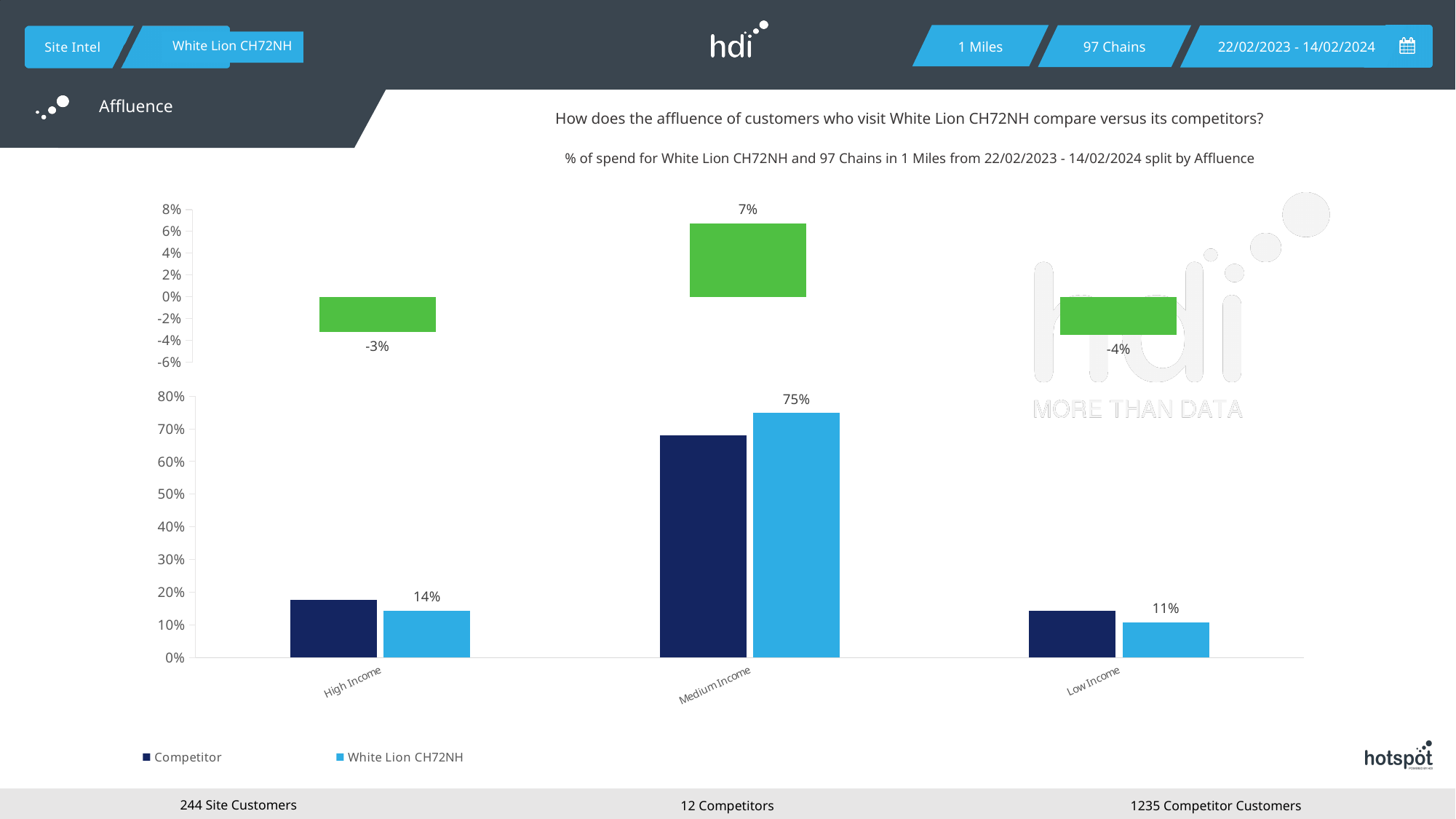
In the bottom chart, what is the value for White Lion CH72NH in the High Income category? 14% In the bottom chart, what is the value for White Lion CH72NH in the Low Income category? 11% In the bottom chart, what is the difference between the White Lion CH72NH values for Medium Income and High Income? 61% In the top chart, what is the value shown for Low Income? -4% In the bottom chart, which category has the highest value for White Lion CH72NH? Medium Income What type of chart is the bottom chart? Bar chart How many series does the legend of the bottom chart list? 2 In the bottom chart, in the High Income category, which series has the larger value, Competitor or White Lion CH72NH? Competitor In the bottom chart, what is the value for White Lion CH72NH in the Medium Income category? 75% In the bottom chart, is the Competitor value for Medium Income greater or less than 60%? greater In the top chart, which category has the lowest value? Low Income In the top chart, what is the value shown for Medium Income? 7%